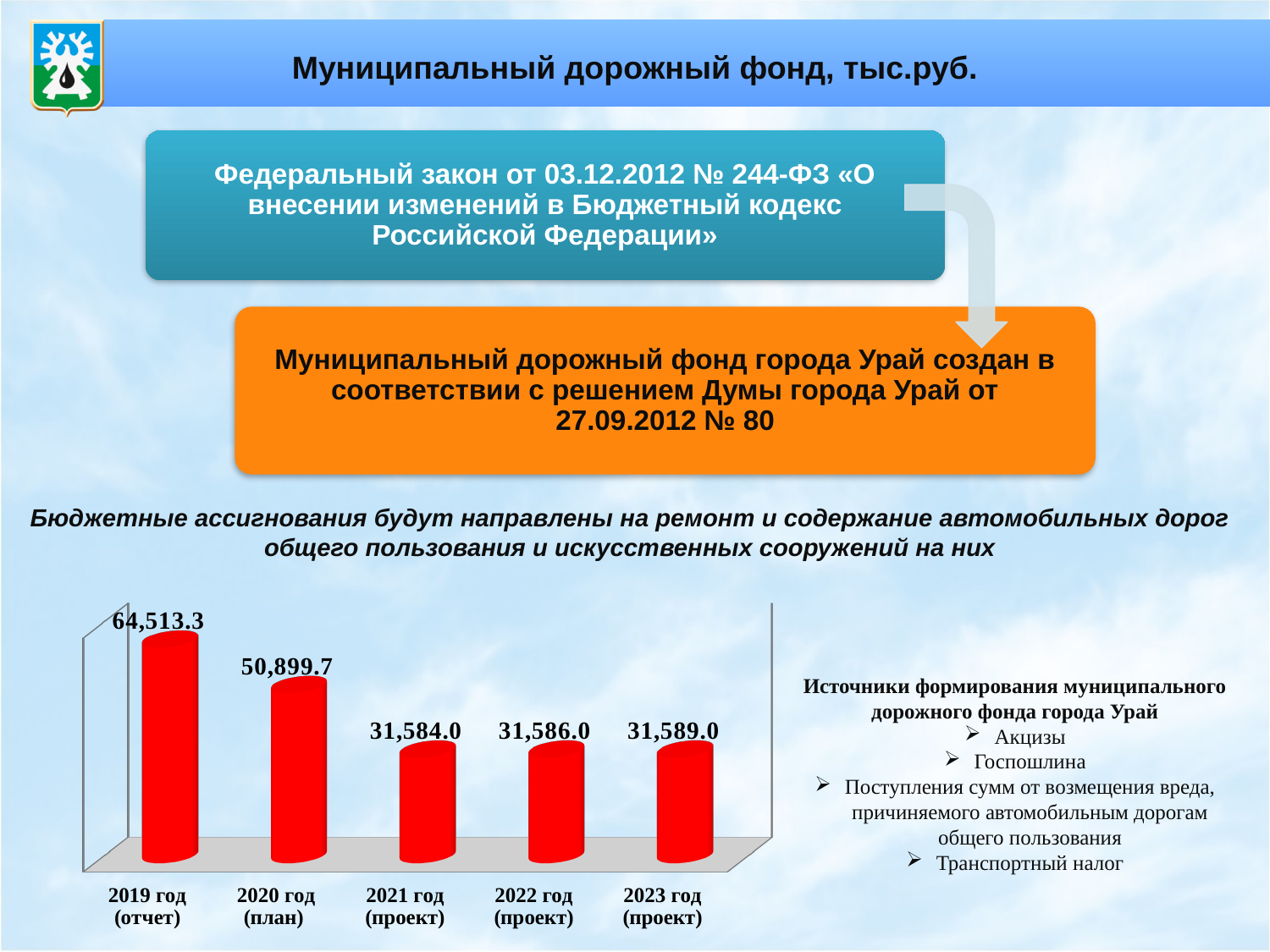
What kind of chart is shown on the slide? bar chart Which is larger, the value for 2020 год (план) or the value for 2023 год (проект)? 2020 год (план) What is the difference between the values for 2019 год (отчет) and 2020 год (план)? 13,613.6 What is the value for 2020 год (план)? 50,899.7 Which year has the highest value? 2019 год (отчет) What is the value for 2019 год (отчет)? 64,513.3 What is the value for 2021 год (проект)? 31,584.0 What is the difference between the values for 2020 год (план) and 2021 год (проект)? 19,315.7 What is the value for 2023 год (проект)? 31,589.0 How many years are shown in the chart? 5 What is the value for 2022 год (проект)? 31,586.0 Do the values rise or fall from 2019 to 2021? fall